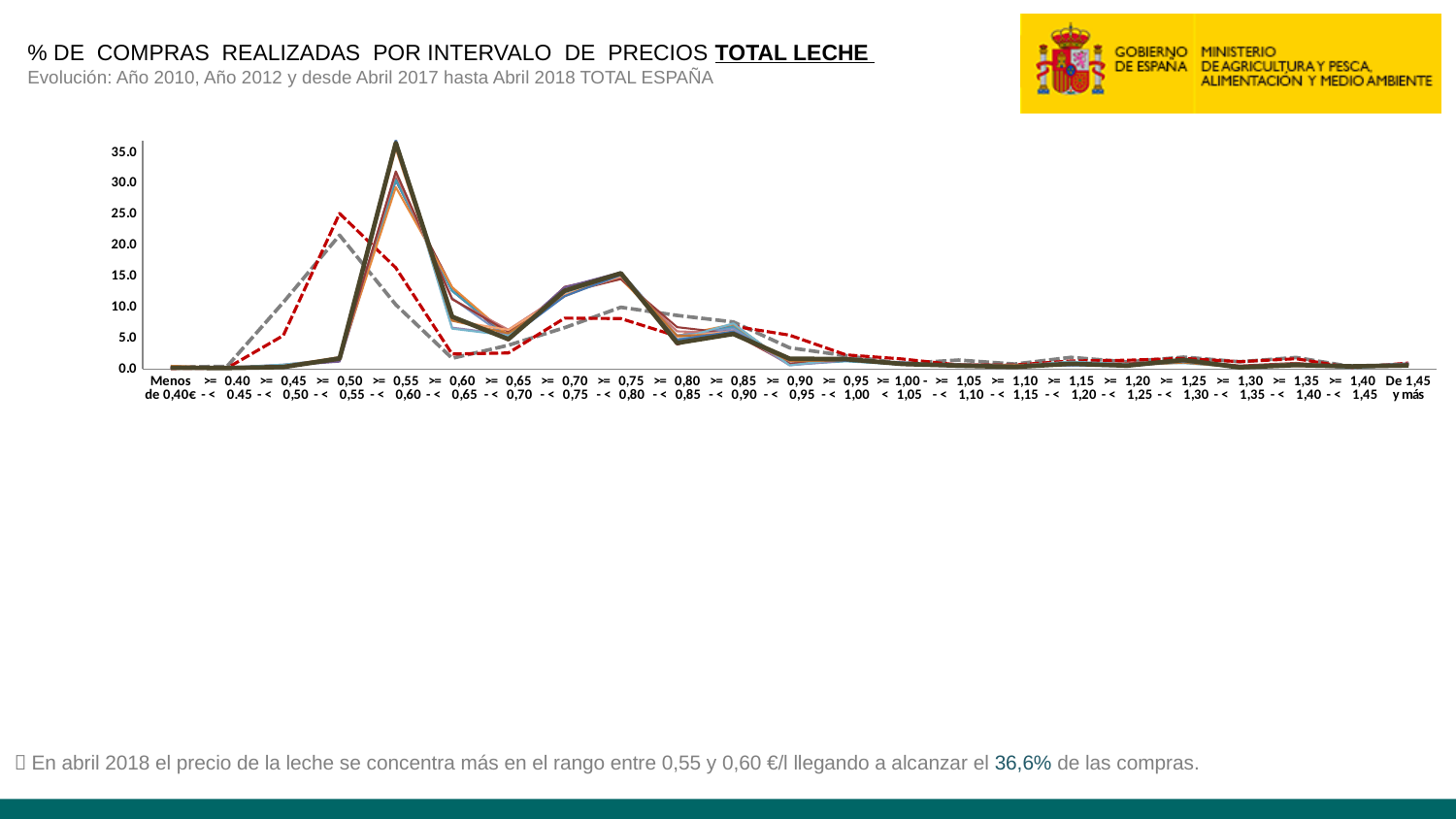
How many price intervals are shown along the x axis of the chart? 23 In which price interval does the thick dark line reach its highest value? >= 0,55 - < 0,60 Is the value of the grey dashed line at the 0,50 - 0,55 interval greater or less than 25? less According to the slide text, what percentage of purchases in April 2018 fell in the 0,55 to 0,60 €/l range? 36,6% Which is larger for the thick dark line: the value at the 0,55 - 0,60 interval or the value at the 0,75 - 0,80 interval? 0,55 - 0,60 Do the values of the lines generally rise or fall from the 0,75 - 0,80 interval towards the right end of the x axis? fall Is the value of the thick dark line at the 0,50 - 0,55 interval greater or less than 5? less What kind of chart is shown on the slide? line chart What is the highest value shown on the y axis of the chart? 35.0 Which product does the chart title say the purchase percentages refer to? TOTAL LECHE Is the peak value of the thick dark line at the 0,55 - 0,60 interval greater or less than 30? greater